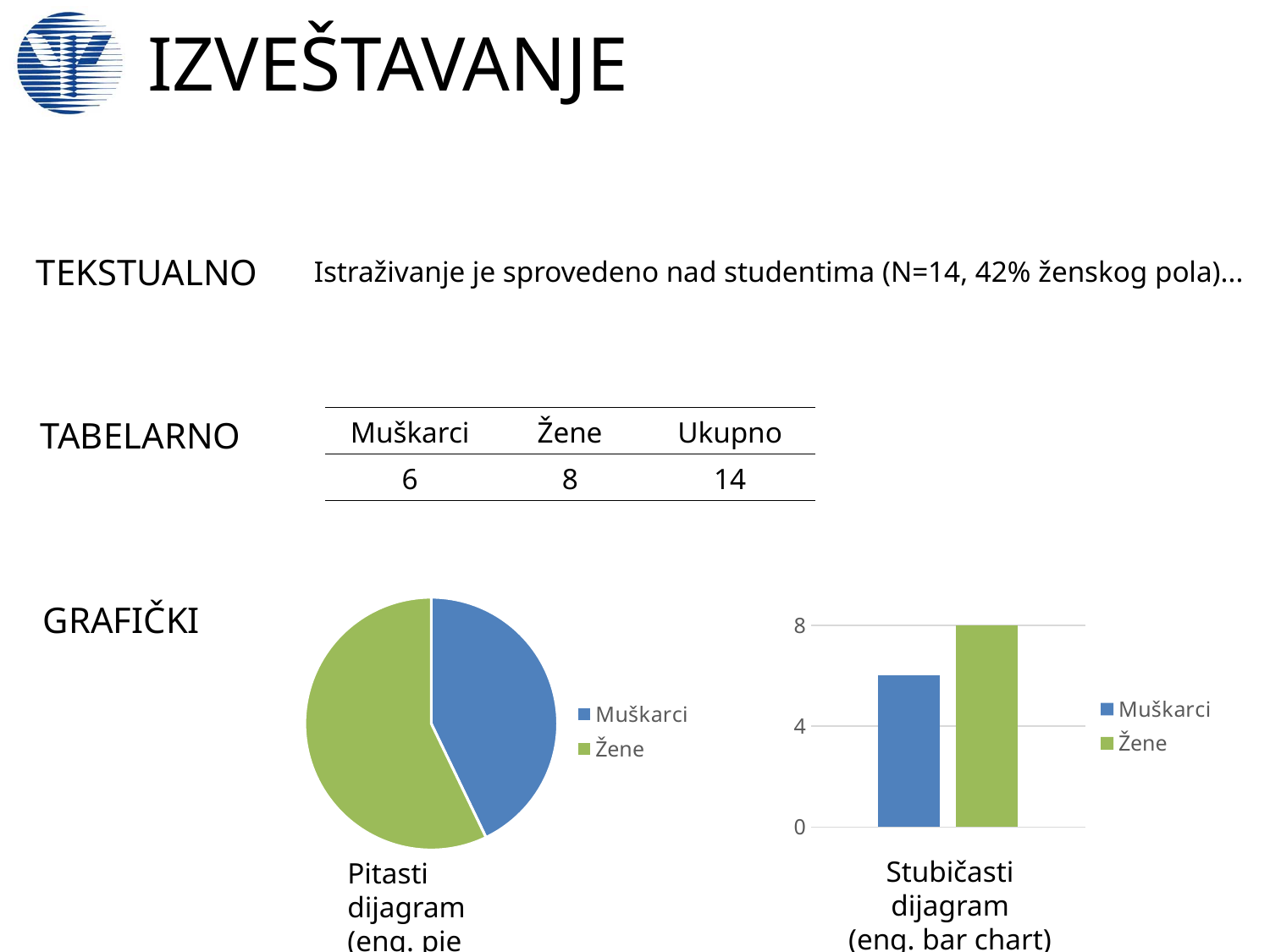
In the pie chart on the left, what colour is the Žene slice? green In the bar chart on the right, what is the value for Žene? 8 In the bar chart on the right, which category has the highest value? Žene In the bar chart on the right, which category has the lowest value? Muškarci How many bars are shown in the bar chart on the right? 2 How many entries does the legend of the pie chart on the left list? 2 In the bar chart on the right, is the value for Muškarci greater or less than 4? greater In the bar chart on the right, is the value for Muškarci greater or less than 8? less In the pie chart on the left, which slice is larger, Muškarci or Žene? Žene What kind of chart is the chart on the right of the slide? bar chart In the bar chart on the right, which is larger, Muškarci or Žene? Žene What kind of chart is the chart on the left of the slide? pie chart